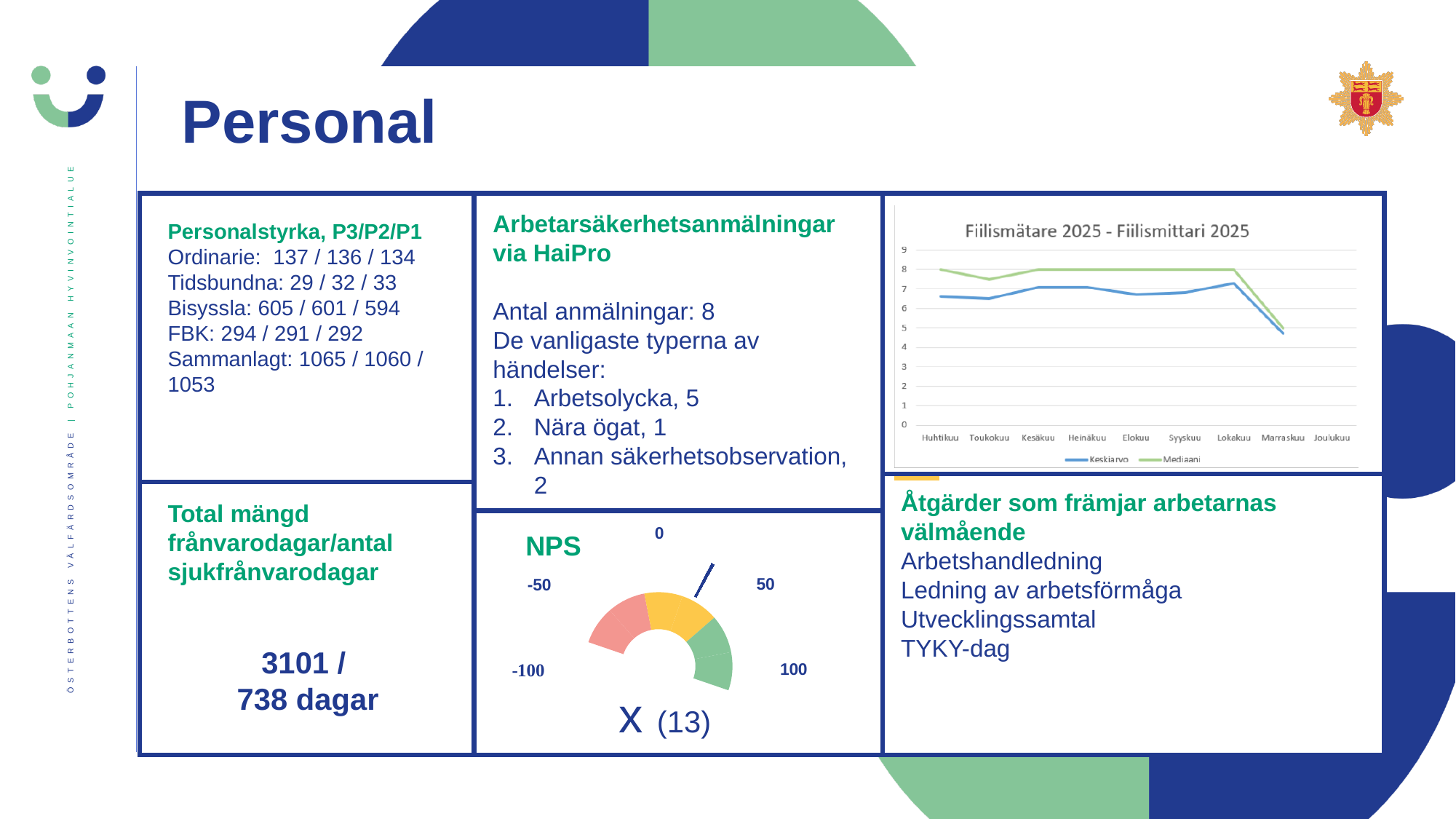
What value is printed below the NPS gauge chart? X (13) How many series does the legend of the 'Fiilismätare 2025 - Fiilismittari 2025' chart list? 2 In the 'Fiilismätare 2025 - Fiilismittari 2025' chart, is the Keskiarvo value for Kesäkuu greater or less than 8? less In the 'Fiilismätare 2025 - Fiilismittari 2025' chart, is the Keskiarvo value for Marraskuu greater or less than 6? less What are the two legend entries in the 'Fiilismätare 2025 - Fiilismittari 2025' chart? Keskiarvo and Mediaani In the 'Fiilismätare 2025 - Fiilismittari 2025' chart, do both series rise or fall from Lokakuu to Marraskuu? fall What kind of chart is the 'Fiilismätare 2025 - Fiilismittari 2025' chart? line chart In the 'Fiilismätare 2025 - Fiilismittari 2025' chart, which series has the higher value in Huhtikuu, Keskiarvo or Mediaani? Mediaani In the 'Fiilismätare 2025 - Fiilismittari 2025' chart, is the Mediaani value for Lokakuu greater or less than 6? greater How many month categories are shown on the x axis of the 'Fiilismätare 2025 - Fiilismittari 2025' chart? 9 In the 'Fiilismätare 2025 - Fiilismittari 2025' chart, in which month is the Keskiarvo series at its lowest? Marraskuu